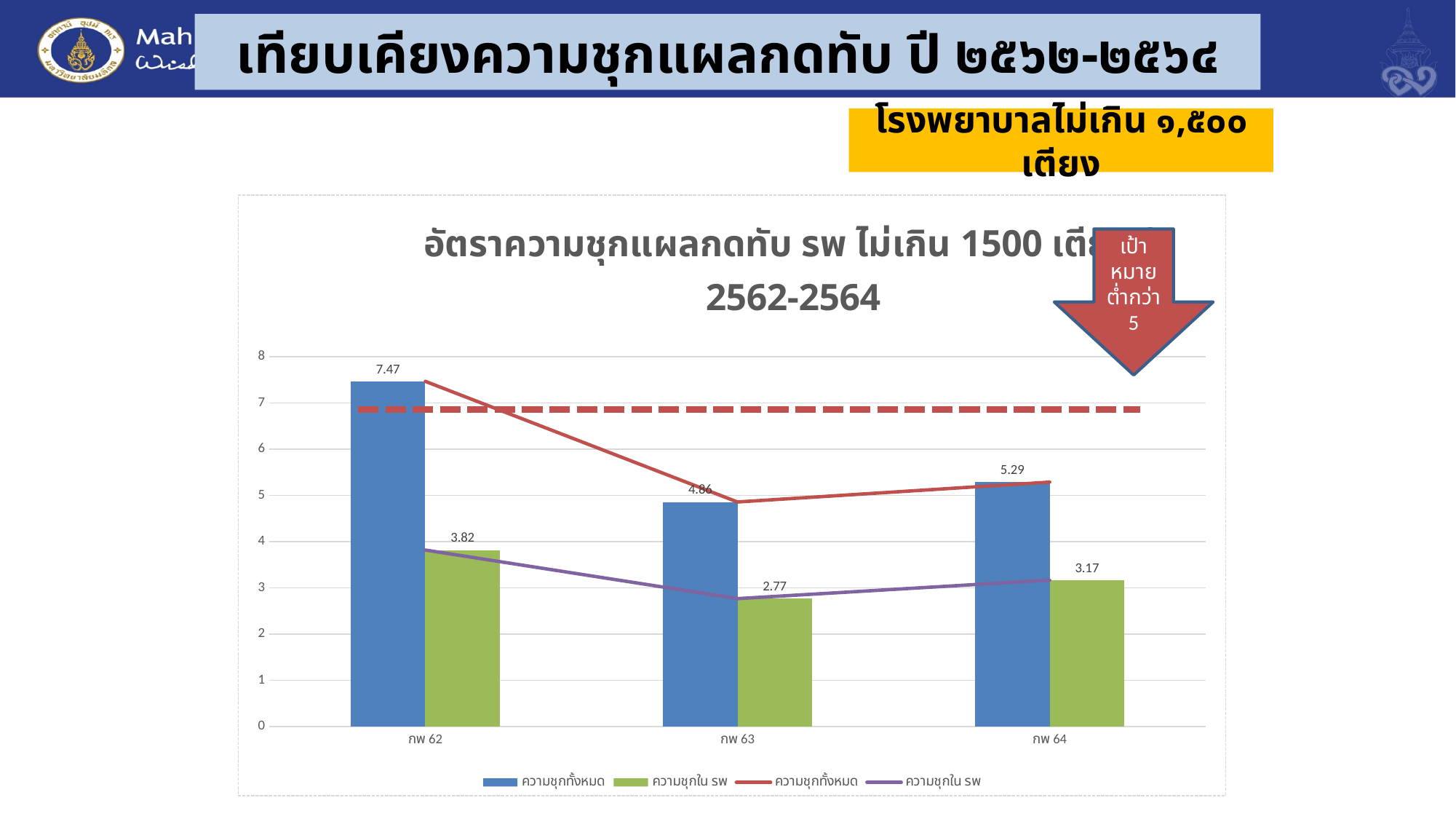
What is the value of ความชุกทั้งหมด for กพ 64? 5.29 How many series does the legend list? 4 What is the value of ความชุกทั้งหมด for กพ 62? 7.47 What is the value of ความชุกใน รพ for กพ 64? 3.17 Which category has the lowest value for ความชุกใน รพ? กพ 63 Which category has the highest value for ความชุกทั้งหมด? กพ 62 Does ความชุกใน รพ rise or fall from กพ 62 to กพ 63? fall Is the value of ความชุกทั้งหมด for กพ 63 greater or less than 5? less What is the difference between ความชุกทั้งหมด for กพ 62 and กพ 63? 2.61 Which is larger: ความชุกใน รพ for กพ 62 or for กพ 64? กพ 62 What is the value of ความชุกใน รพ for กพ 63? 2.77 How many categories are shown on the x axis? 3